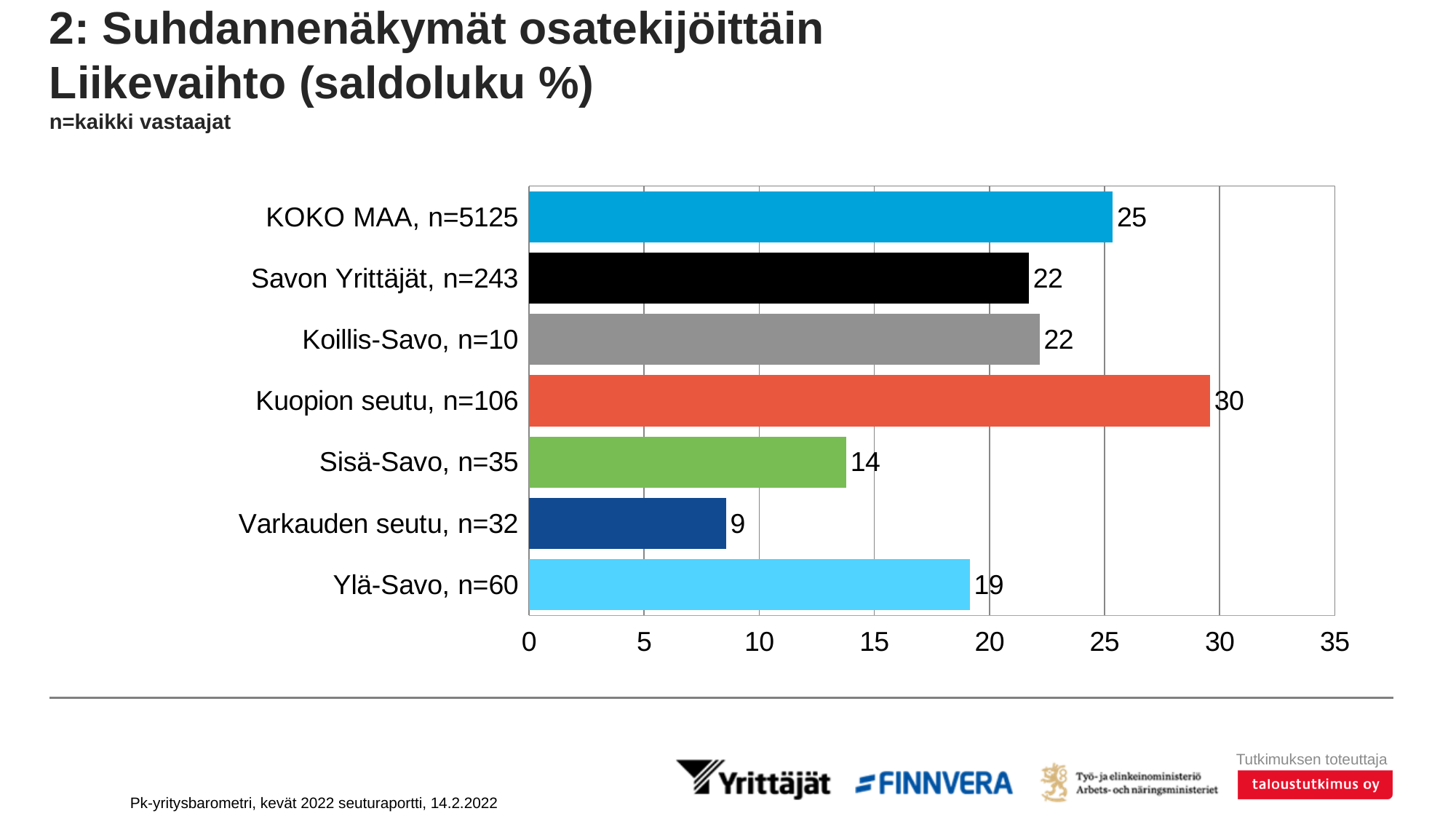
What is the value for Varkauden seutu, n=32? 9 What is the value for KOKO MAA, n=5125? 25 What is the value for Ylä-Savo, n=60? 19 How many categories are shown in the chart? 7 Which category has the highest value? Kuopion seutu, n=106 What is the difference between the values for Kuopion seutu, n=106 and Sisä-Savo, n=35? 16 Is the value for Savon Yrittäjät, n=243 greater or less than 20? greater Which category has the lowest value? Varkauden seutu, n=32 What is the value for Kuopion seutu, n=106? 30 What is the maximum value shown on the horizontal axis? 35 Which is larger, the value for Ylä-Savo, n=60 or the value for Sisä-Savo, n=35? Ylä-Savo, n=60 What kind of chart is shown on the slide? bar chart